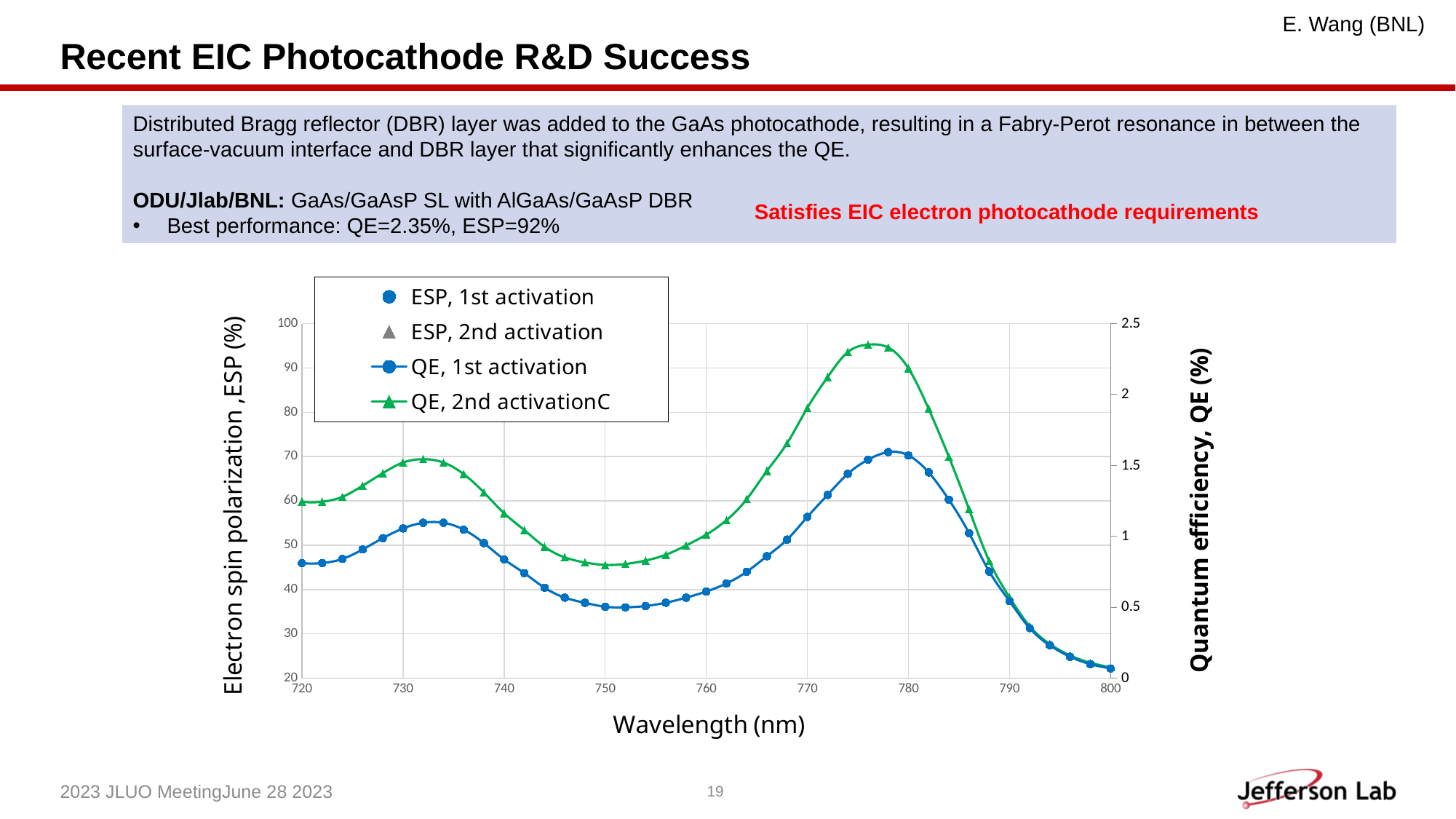
What is the title of the right-hand y axis of the chart? Quantum efficiency, QE (%) What is the maximum value shown on the right-hand QE axis? 2.5 Is the QE, 1st activation value at 800 nm greater or less than 0.5 on the right-hand QE axis? less What kind of chart is shown on the slide? line chart Between 780 nm and 800 nm, do the QE, 2nd activation values rise or fall as wavelength increases? fall How many series does the chart legend list? 4 Is the peak value of the QE, 2nd activation series greater or less than 2 on the right-hand QE axis? greater At 760 nm, which series has the higher value: QE, 1st activation or QE, 2nd activation? QE, 2nd activation Is the peak value of the QE, 1st activation series greater or less than 2 on the right-hand QE axis? less What is the title of the x axis of the chart? Wavelength (nm)